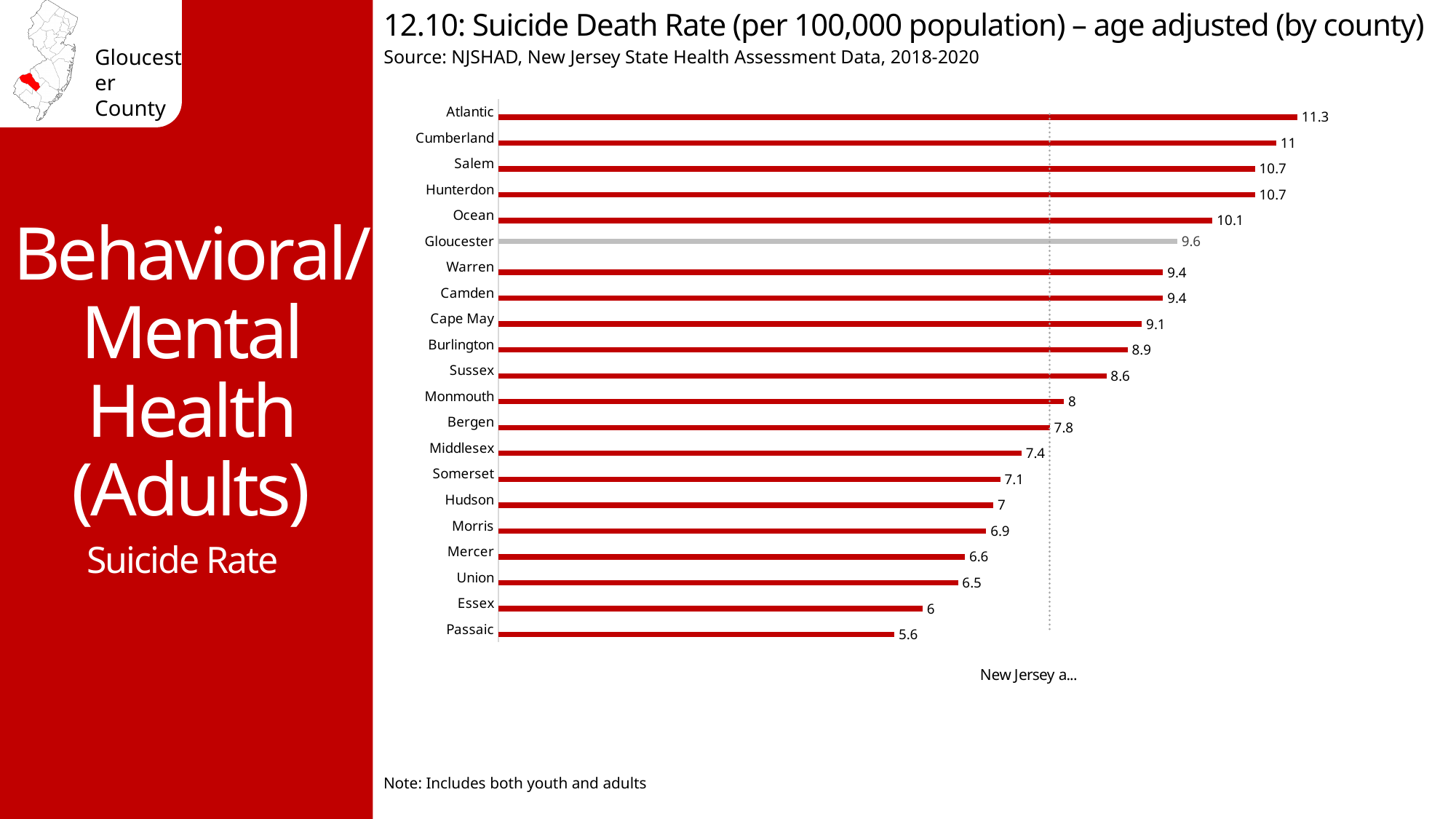
What is the suicide death rate for Hudson County? 7 Which county's bar is shown in gray rather than red? Gloucester Which county has the lowest suicide death rate? Passaic What is the suicide death rate for Gloucester County? 9.6 What is the difference between the suicide death rates of Gloucester and Camden counties? 0.2 What is the suicide death rate for Passaic County? 5.6 How many counties are shown in the chart? 21 Which county has the highest suicide death rate? Atlantic What is the difference between the suicide death rates of Atlantic and Passaic counties? 5.7 What is the suicide death rate for Atlantic County? 11.3 What kind of chart is shown on the slide? Bar chart Which county has a higher suicide death rate, Ocean or Bergen? Ocean